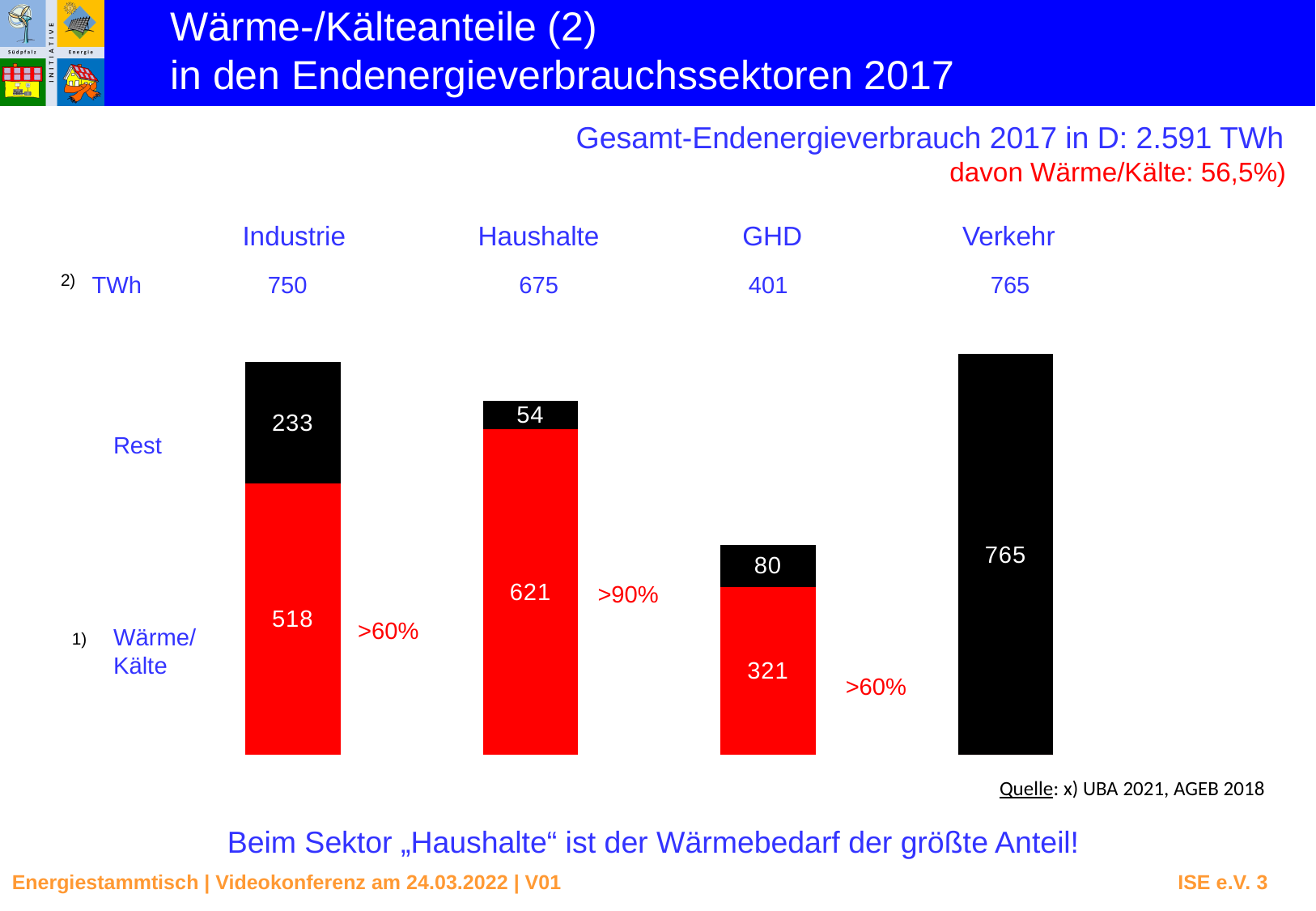
What is the Wärme/Kälte value for Industrie? 518 What is the total of the stacked bar for Haushalte? 675 What is the total of the stacked bar for GHD? 401 What is the Wärme/Kälte value for GHD? 321 Which sector has the lowest Rest value? Haushalte What is the Rest value for Haushalte? 54 How many sectors are shown in the chart? 4 What type of chart is shown on the slide? Stacked bar chart What is the difference between the Wärme/Kälte values of Haushalte and GHD? 300 Which is larger, the Rest value for Industrie or the Rest value for GHD? Industrie What value is shown for the Verkehr bar? 765 Which sector has the highest Wärme/Kälte value? Haushalte